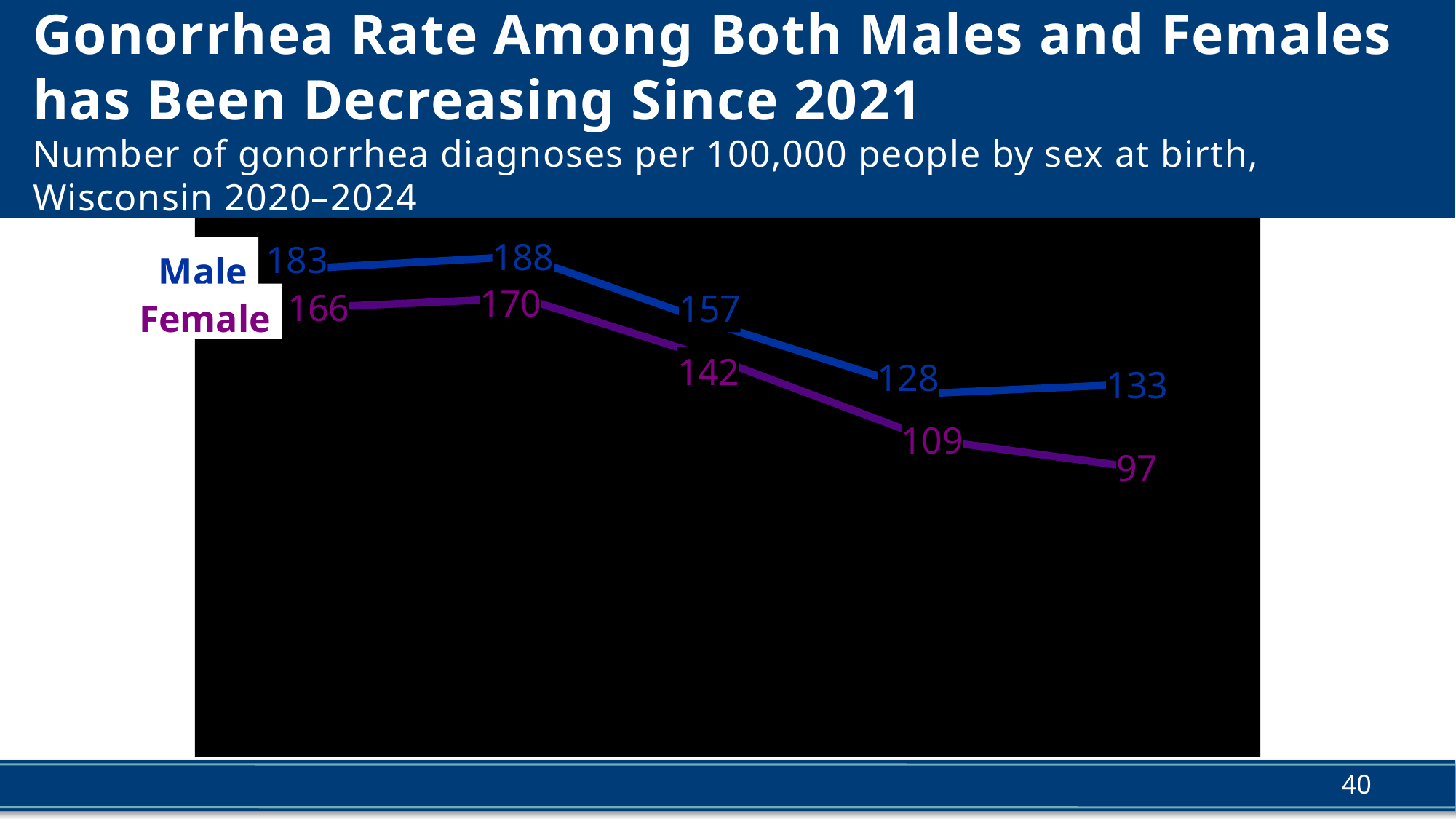
What is the value of the first point on the Male line? 183 What is the value of the third point on the Male line? 157 Does the Female line rise or fall from its second point to its last point? fall What colour is the Female line? purple What is the value of the last point on the Female line? 97 What kind of chart is shown on the slide? line chart What is the highest value on the Female line? 170 What is the lowest value on the Male line? 128 How many series does the chart show? 2 Which is larger at the last point: the Male value or the Female value? Male What is the difference between the second point on the Male line (188) and the second point on the Female line (170)? 18 How many data points does the Male line have? 5